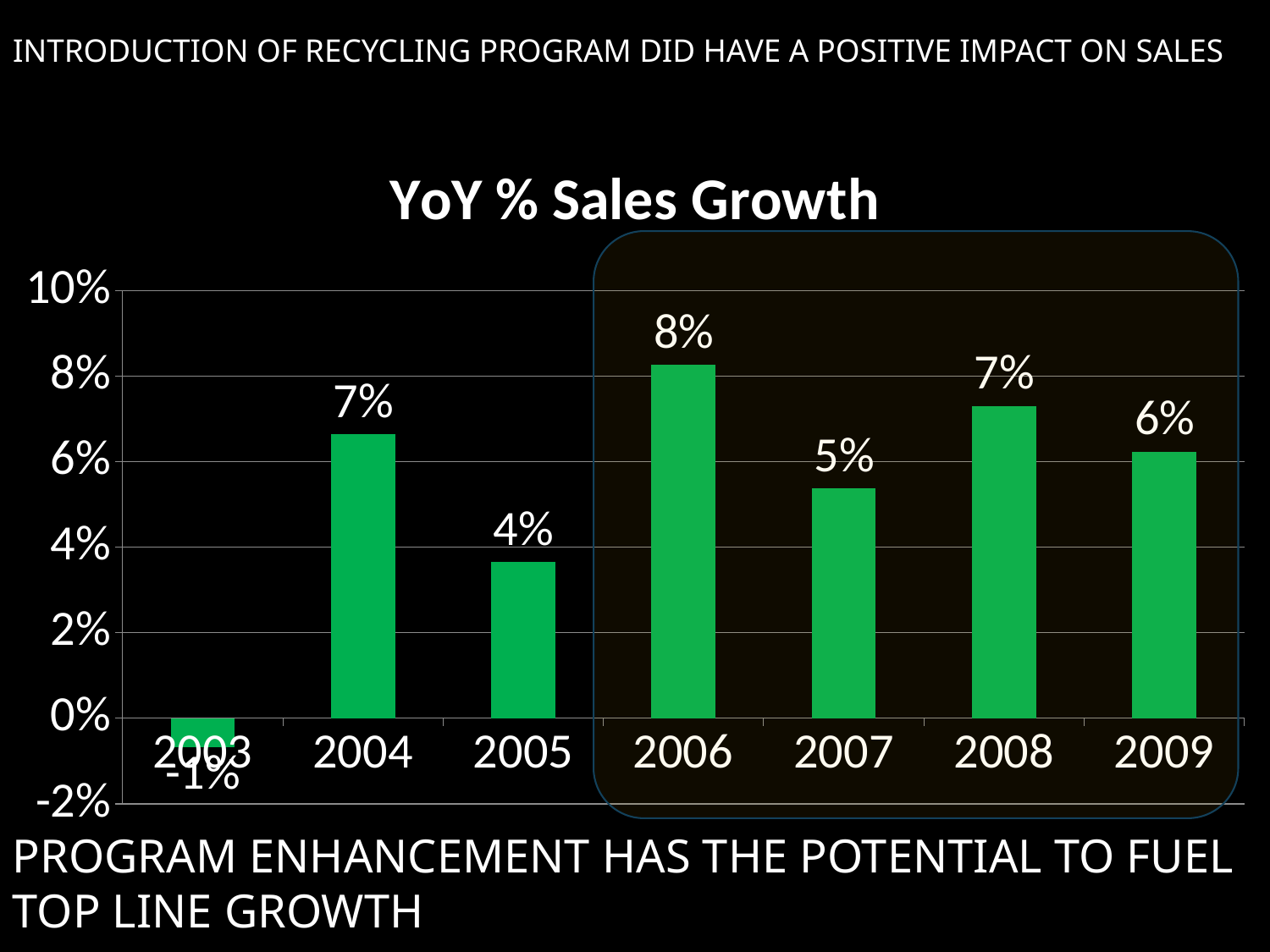
Which year has the highest YoY % sales growth? 2006 Which year has the lowest YoY % sales growth? 2003 What is the YoY % sales growth for 2003? -1% How many years are shown on the chart? 7 What is the YoY % sales growth for 2006? 8% Is the YoY % sales growth for 2005 greater or less than 6%? less What is the title of the chart? YoY % Sales Growth What kind of chart is shown on the slide? bar chart What is the YoY % sales growth for 2007? 5% Which year has higher YoY % sales growth, 2005 or 2009? 2009 What is the YoY % sales growth for 2009? 6% What is the difference between the YoY % sales growth in 2006 and 2007? 3%